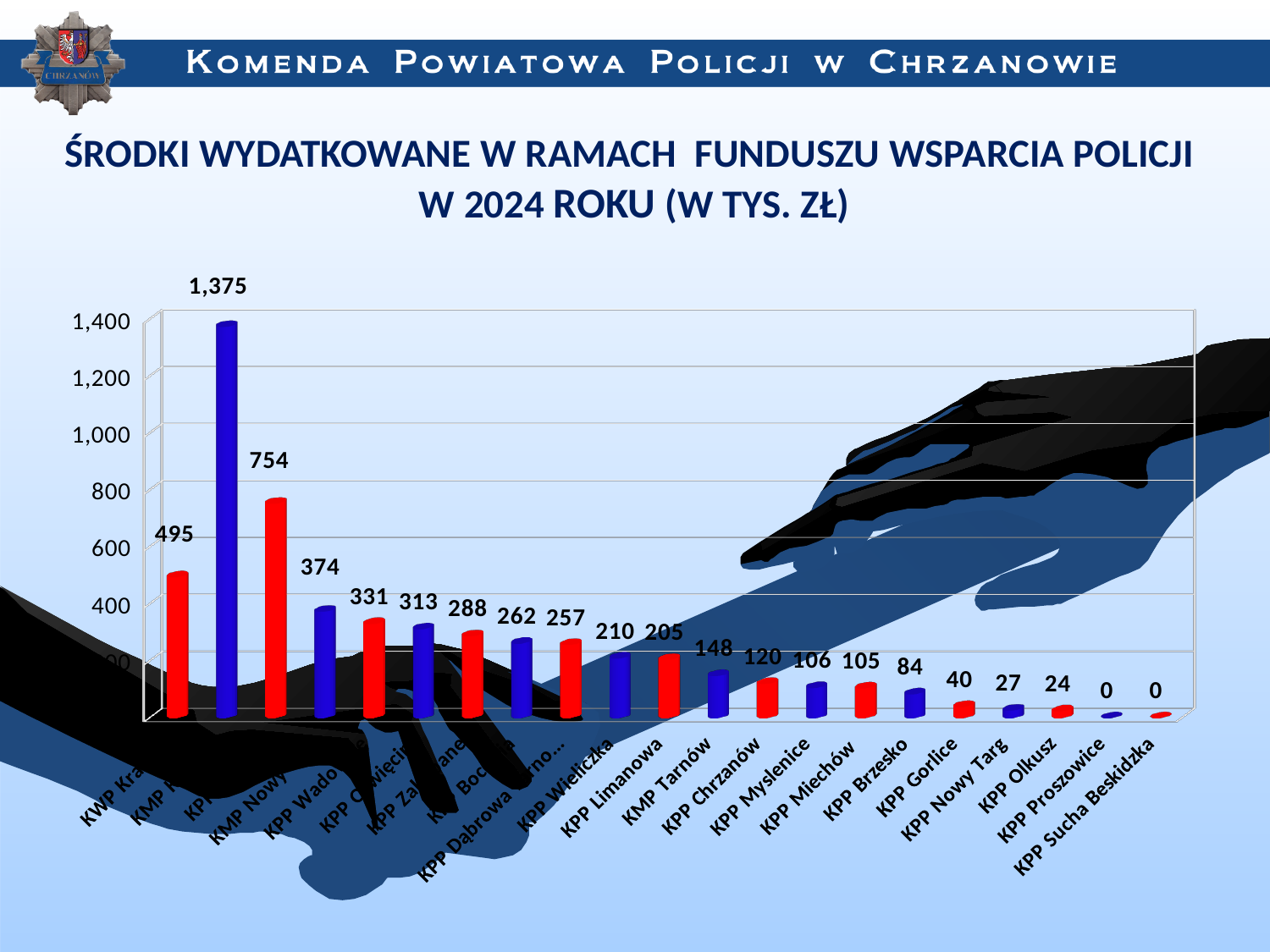
What is the value for KPP Gorlice? 40 What is the difference between the values for KMP Tarnów and KPP Chrzanów? 28 How many bars are plotted on the chart? 21 What is the value for KMP Tarnów? 148 Which has a larger value, KPP Brzesko or KPP Gorlice? KPP Brzesko What is the value for KPP Sucha Beskidzka? 0 What is the difference between the values for KPP Wieliczka and KPP Limanowa? 5 What is the value for KPP Chrzanów? 120 What kind of chart is shown on the slide? Bar chart What is the value for KPP Wieliczka? 210 Do the values rise or fall along the x axis from KPP Wieliczka to KPP Sucha Beskidzka? Fall What is the highest value shown on the chart? 1,375